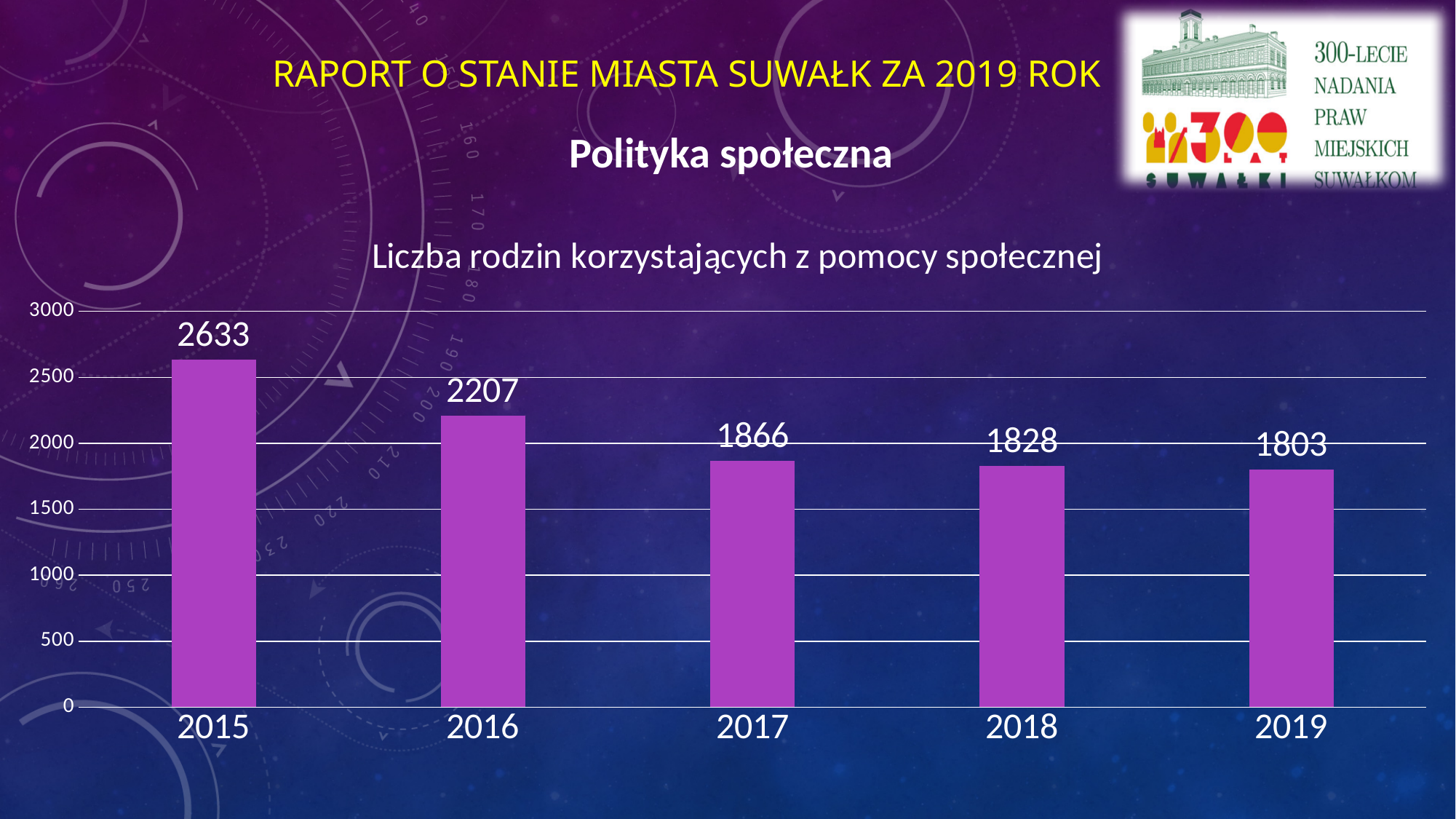
What value is shown for 2017? 1866 What is the number of families using social assistance in 2015? 2633 What is the difference between the values for 2015 and 2016? 426 Which year has the lowest value? 2019 What is the difference between the values for 2018 and 2019? 25 How many years are shown on the x axis? 5 Which year has the highest value? 2015 Do the values rise or fall from 2015 to 2019? fall Which year has a larger value, 2016 or 2017? 2016 What kind of chart is shown on the slide? bar chart What value is shown for 2019? 1803 Is the value for 2018 greater or less than 2000? less